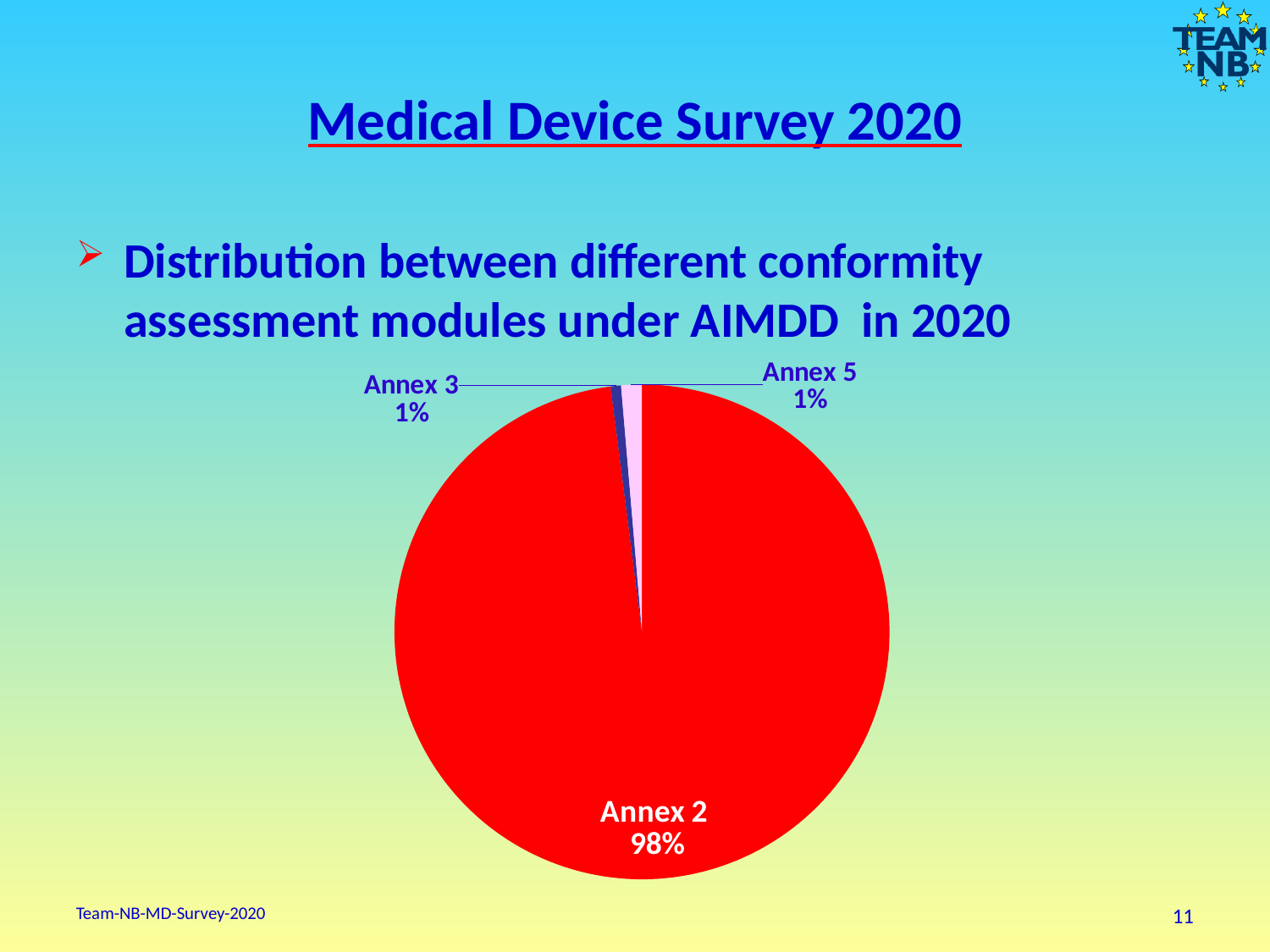
Which slices of the pie chart are labelled with 1%? Annex 3 and Annex 5 According to the slide text, what does the pie chart show the distribution of? different conformity assessment modules under AIMDD in 2020 Which slice of the pie chart is the largest? Annex 2 What percentage of the pie chart is Annex 5? 1% How many slices does the pie chart have? 3 What is the difference in percentage points between Annex 2 and Annex 3 in the pie chart? 97 What share of the pie does the Annex 2 slice take? 98% What colour is the Annex 2 slice in the pie chart? red What percentage of the pie chart is Annex 2? 98% What percentage of the pie chart is Annex 3? 1% What kind of chart is shown on the slide? pie chart Which is larger in the pie chart, Annex 2 or Annex 5? Annex 2